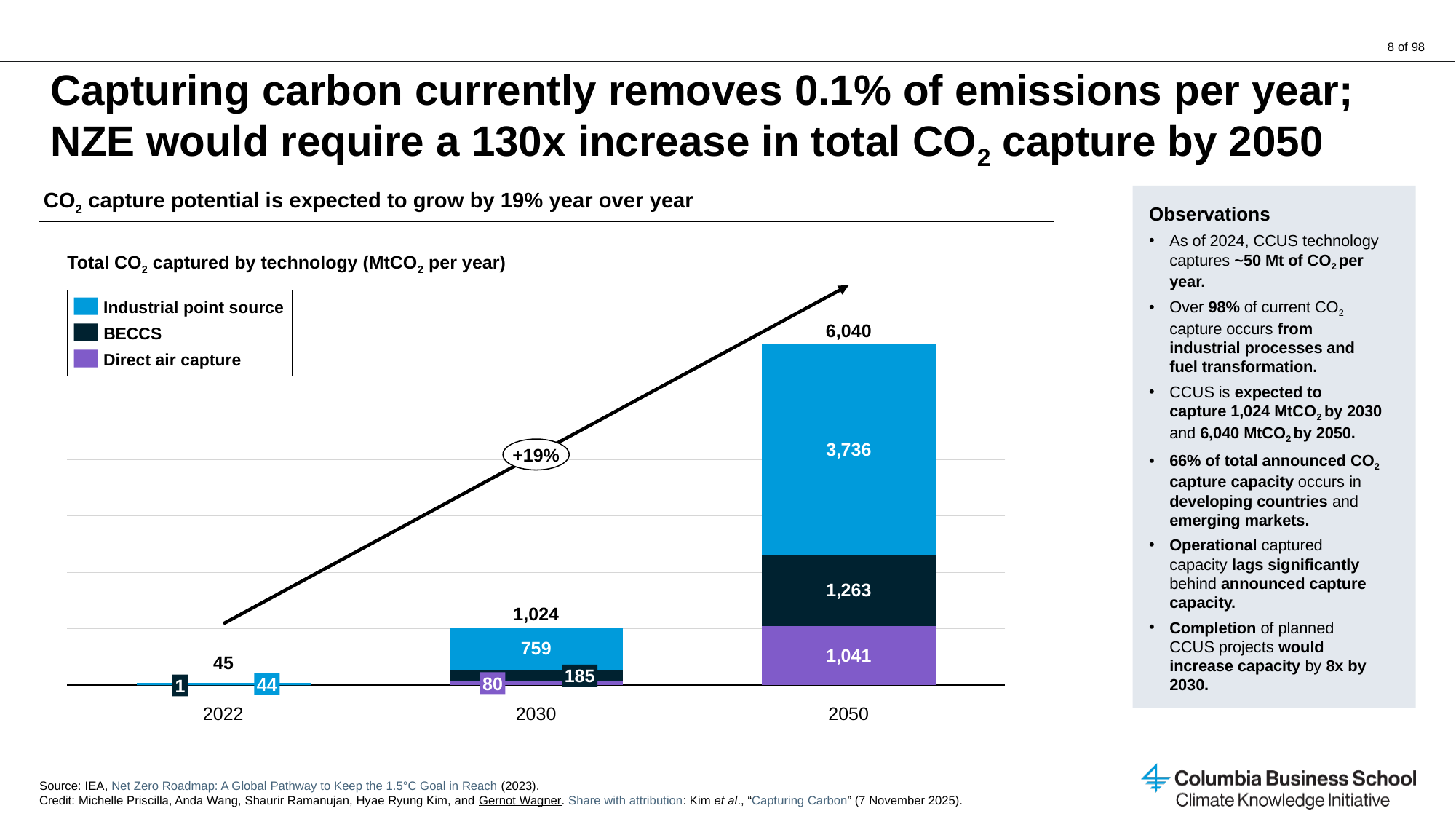
What kind of chart is shown on the slide? Stacked bar chart What growth rate is labelled on the arrow across the chart? +19% In 2050, which is larger: BECCS or Direct air capture? BECCS What is the value for BECCS in 2050? 1,263 What is the total CO2 captured in 2050 according to the chart? 6,040 How many years are shown on the x axis of the chart? 3 What is the difference between the total for 2050 and the total for 2030? 5,016 What is the value for Industrial point source in 2030? 759 What is the value for Direct air capture in 2030? 80 Which year has the highest total CO2 captured? 2050 How many series does the chart legend list? 3 Which year has the lowest total CO2 captured? 2022